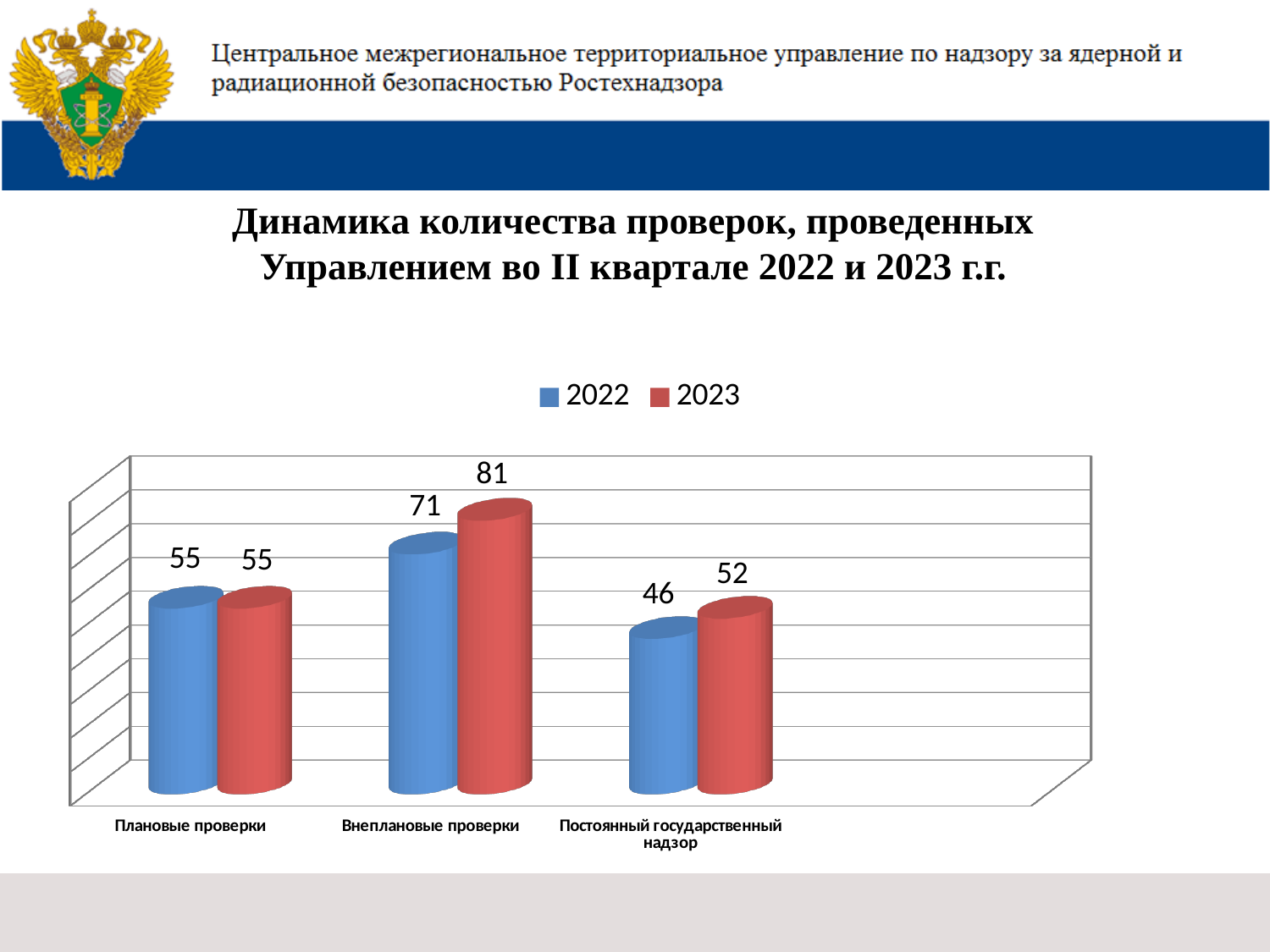
Which category has the lowest value in 2022? Постоянный государственный надзор How many categories are shown on the x axis? 3 What is the difference between the 2023 and 2022 values for Внеплановые проверки? 10 What is the value for Постоянный государственный надзор in 2022? 46 What is the value for Внеплановые проверки in 2023? 81 What is the value for Постоянный государственный надзор in 2023? 52 Which category has the highest value in 2023? Внеплановые проверки Which is larger for Внеплановые проверки: the 2022 value or the 2023 value? 2023 What is the difference between the 2023 and 2022 values for Постоянный государственный надзор? 6 What kind of chart is shown on the slide? Bar chart How many series does the legend list? 2 What is the value for Плановые проверки in 2022? 55